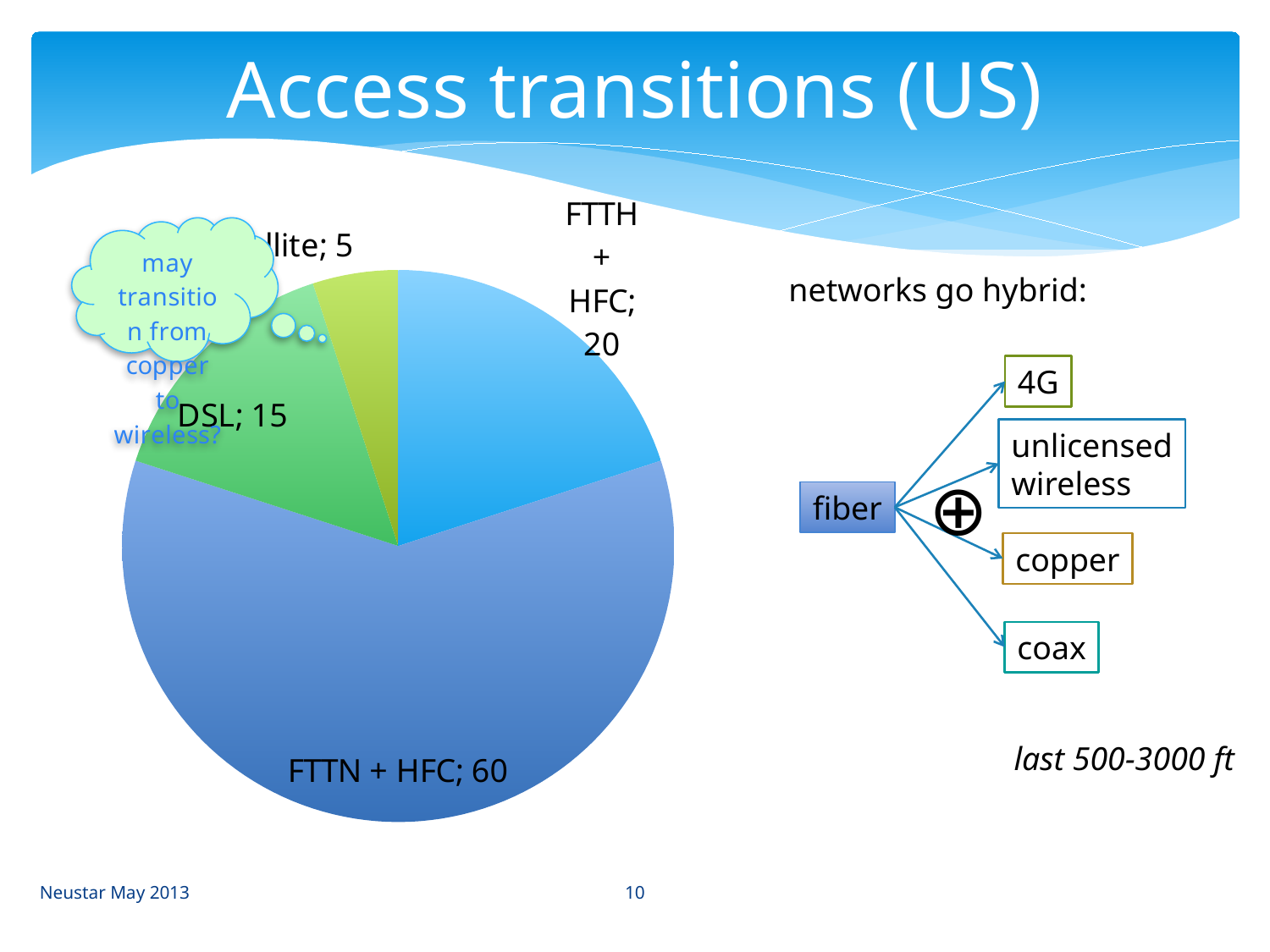
What share of the pie does DSL represent? 15% Which is larger in the pie chart, DSL or FTTH + HFC? FTTH + HFC What is the difference between the values for FTTH + HFC and DSL? 5 How many slices does the pie chart have? 4 What is the value for DSL in the pie chart? 15 What is the difference between the values for FTTN + HFC and FTTH + HFC? 40 What is the value for FTTH + HFC in the pie chart? 20 What colour is the FTTN + HFC slice in the pie chart? blue What kind of chart is shown on the slide? pie chart What share of the pie does FTTN + HFC represent? 60% Which category has the largest slice in the pie chart? FTTN + HFC What is the value for FTTN + HFC in the pie chart? 60